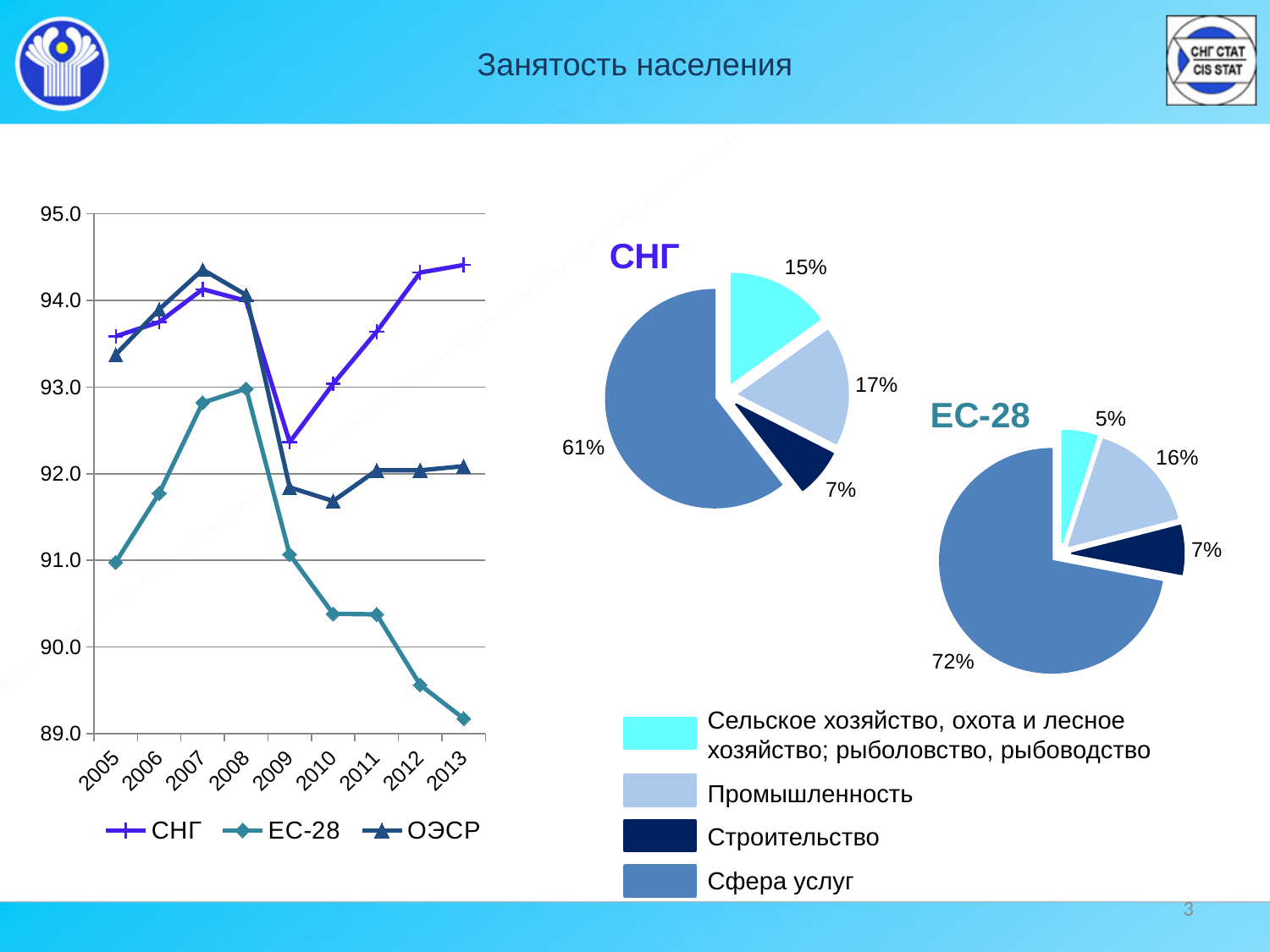
How many years are shown on the x axis of the line chart on the left? 9 In the ЕС-28 pie chart, which category has the largest slice? Сфера услуг What kind of chart is the chart on the left of the slide? line chart In the line chart on the left, is the value for ЕС-28 in 2013 greater or less than 90.0? less In the line chart on the left, is the value for СНГ in 2013 greater or less than 94.0? greater How many series does the legend of the line chart on the left list? 3 In the СНГ pie chart, what share does Сфера услуг have? 61% In the line chart on the left, does the ЕС-28 series rise or fall from 2008 to 2013? fall In the line chart on the left, is the value for ОЭСР in 2010 greater or less than 92.0? less In the line chart on the left, which series has the lowest value in 2013? ЕС-28 In the line chart on the left, which is larger in 2009: the value for СНГ or the value for ЕС-28? СНГ In the ЕС-28 pie chart, what share does Сельское хозяйство, охота и лесное хозяйство; рыболовство, рыбоводство have? 5%